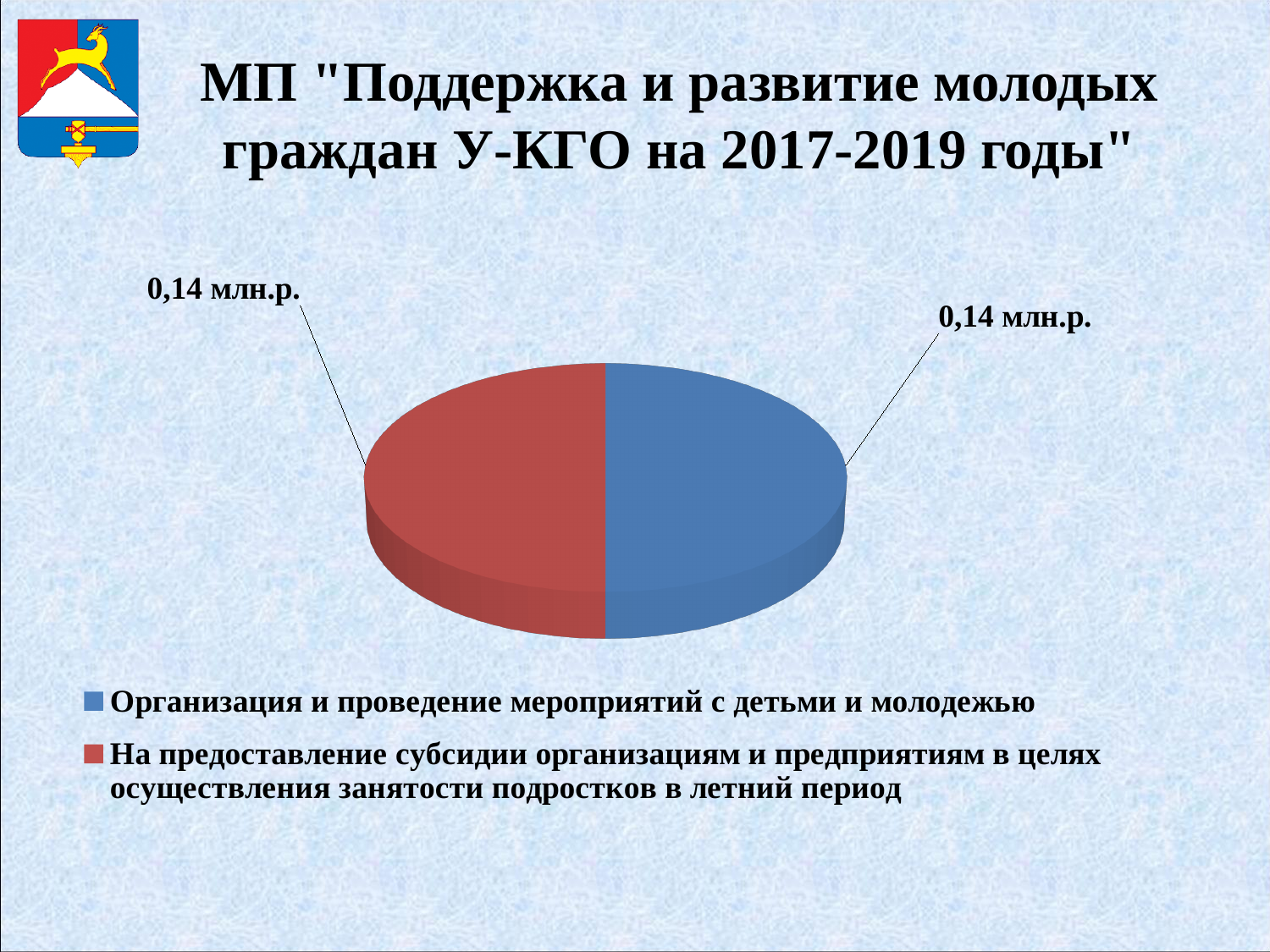
What share of the pie does "Организация и проведение мероприятий с детьми и молодежью" represent? 50% How many entries does the legend list? 2 Which colour represents "На предоставление субсидии организациям и предприятиям в целях осуществления занятости подростков в летний период"? red How many slices does the pie chart have? 2 What is the value for "Организация и проведение мероприятий с детьми и молодежью"? 0,14 млн.р. Which colour represents "Организация и проведение мероприятий с детьми и молодежью"? blue What share of the pie does "На предоставление субсидии организациям и предприятиям в целях осуществления занятости подростков в летний период" represent? 50% What is the difference between the two slice values? 0 млн.р. What is the total of the two slices in the pie chart? 0,28 млн.р. What kind of chart is shown on the slide? pie chart What is the value for "На предоставление субсидии организациям и предприятиям в целях осуществления занятости подростков в летний период"? 0,14 млн.р.